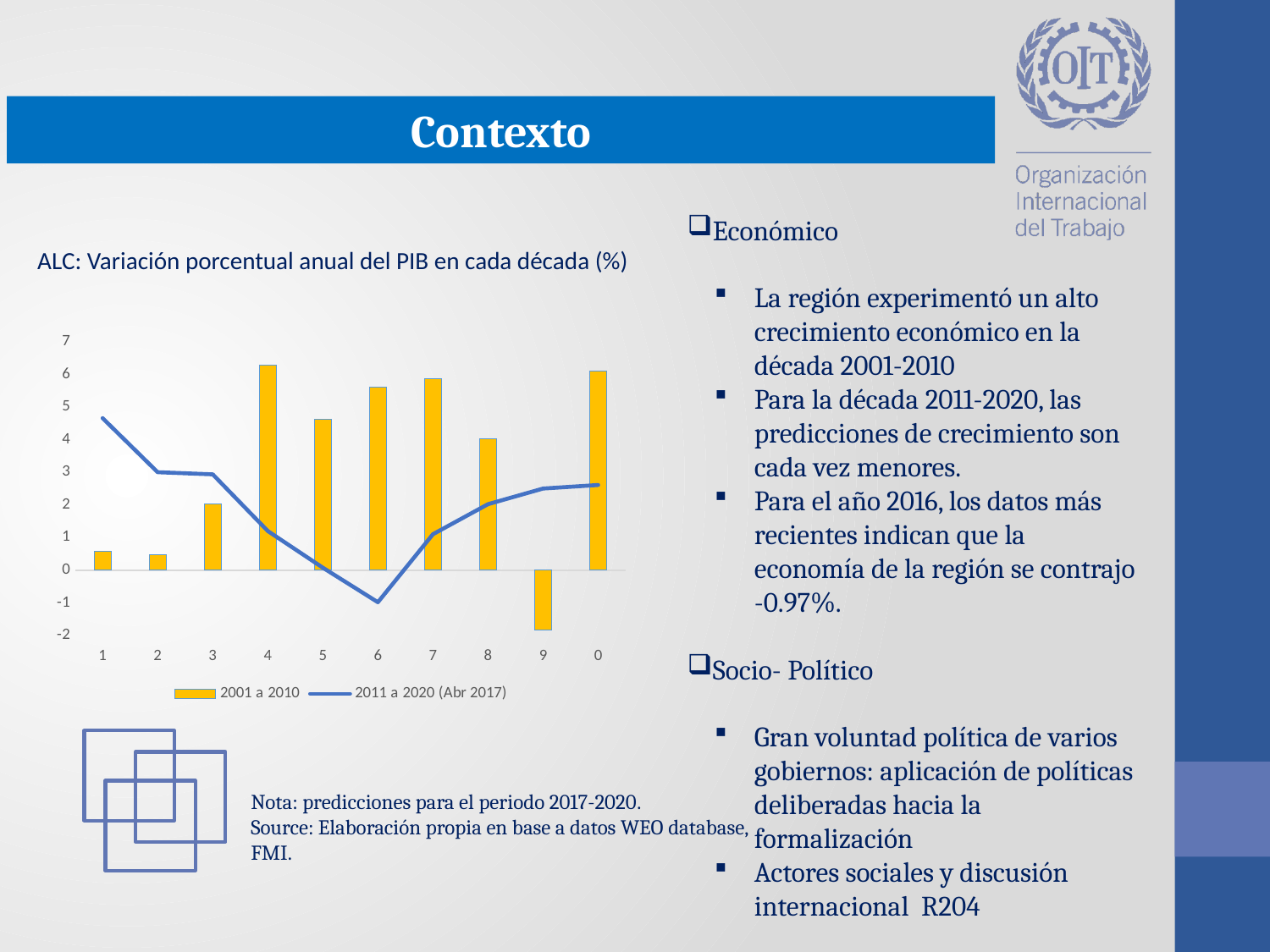
Is the 2011 a 2020 (Abr 2017) value for category 6 greater or less than 0? less Which is larger for the 2001 a 2010 series: the bar for category 3 or the bar for category 4? Category 4 Does the 2011 a 2020 (Abr 2017) line rise or fall from category 1 to category 6? Fall What kind of chart is shown on the slide? A combined bar and line chart How many series does the chart legend list? 2 What is the title of the chart? ALC: Variación porcentual anual del PIB en cada década (%) At which category does the 2011 a 2020 (Abr 2017) line reach its lowest value? 6 How many categories are shown on the x axis of the chart? 10 Which category has the lowest bar for the 2001 a 2010 series? 9 Which series is shown as bars in the chart? 2001 a 2010 Is the 2001 a 2010 bar for category 4 greater or less than 5? greater At which category does the 2011 a 2020 (Abr 2017) line reach its highest value? 1